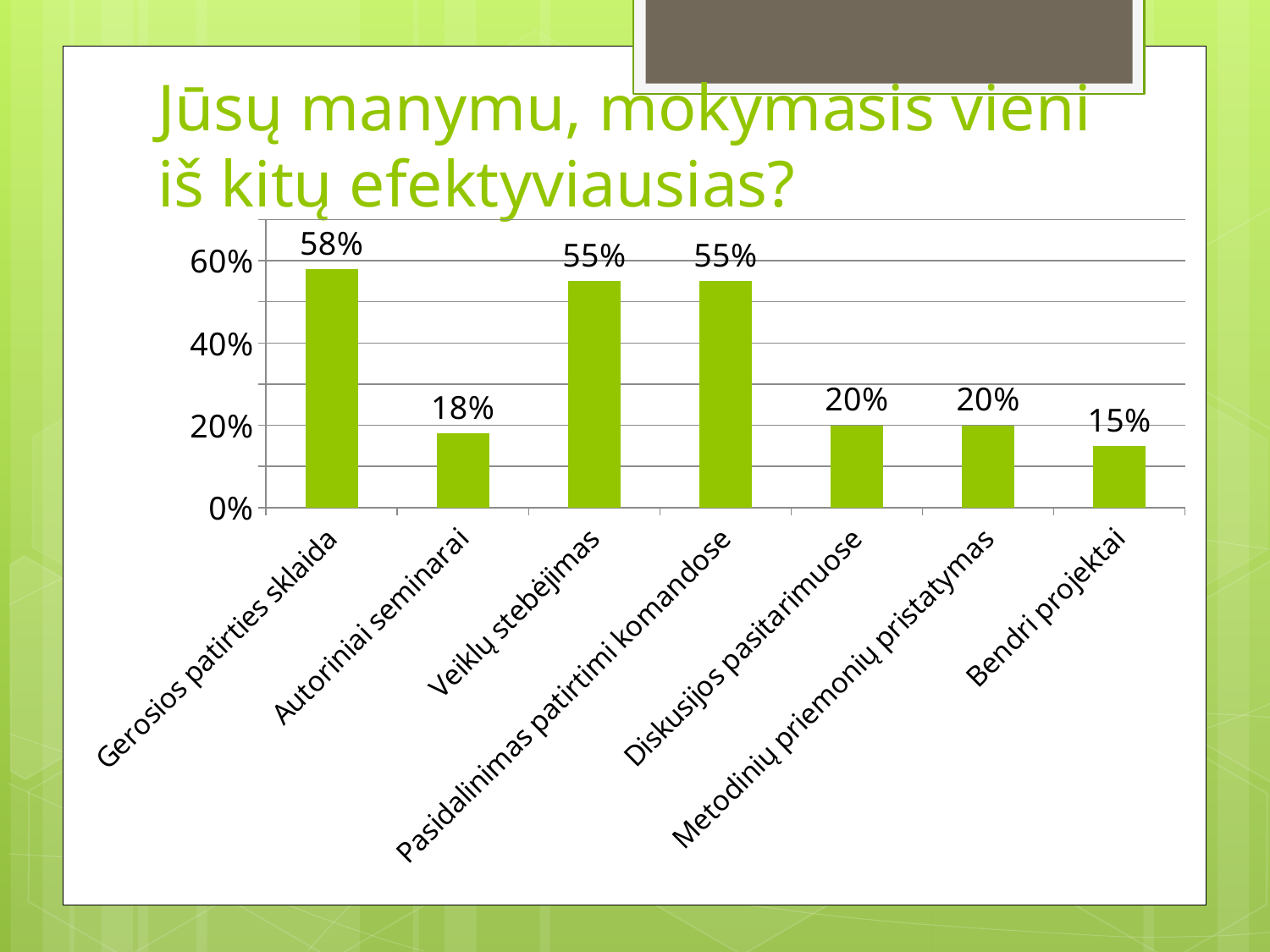
What is the value for Bendri projektai? 15% Is the value for Pasidalinimas patirtimi komandose greater or less than 40%? greater What is the value for Autoriniai seminarai? 18% Which is larger, the value for Veiklų stebėjimas or the value for Metodinių priemonių pristatymas? Veiklų stebėjimas Which category has the highest value? Gerosios patirties sklaida How many categories are shown in the chart? 7 Which category has the lowest value? Bendri projektai What is the value for Gerosios patirties sklaida? 58% What is the difference between the values for Veiklų stebėjimas and Bendri projektai? 40% What kind of chart is shown on the slide? Bar chart What is the difference between the values for Gerosios patirties sklaida and Autoriniai seminarai? 40% What is the value for Diskusijos pasitarimuose? 20%